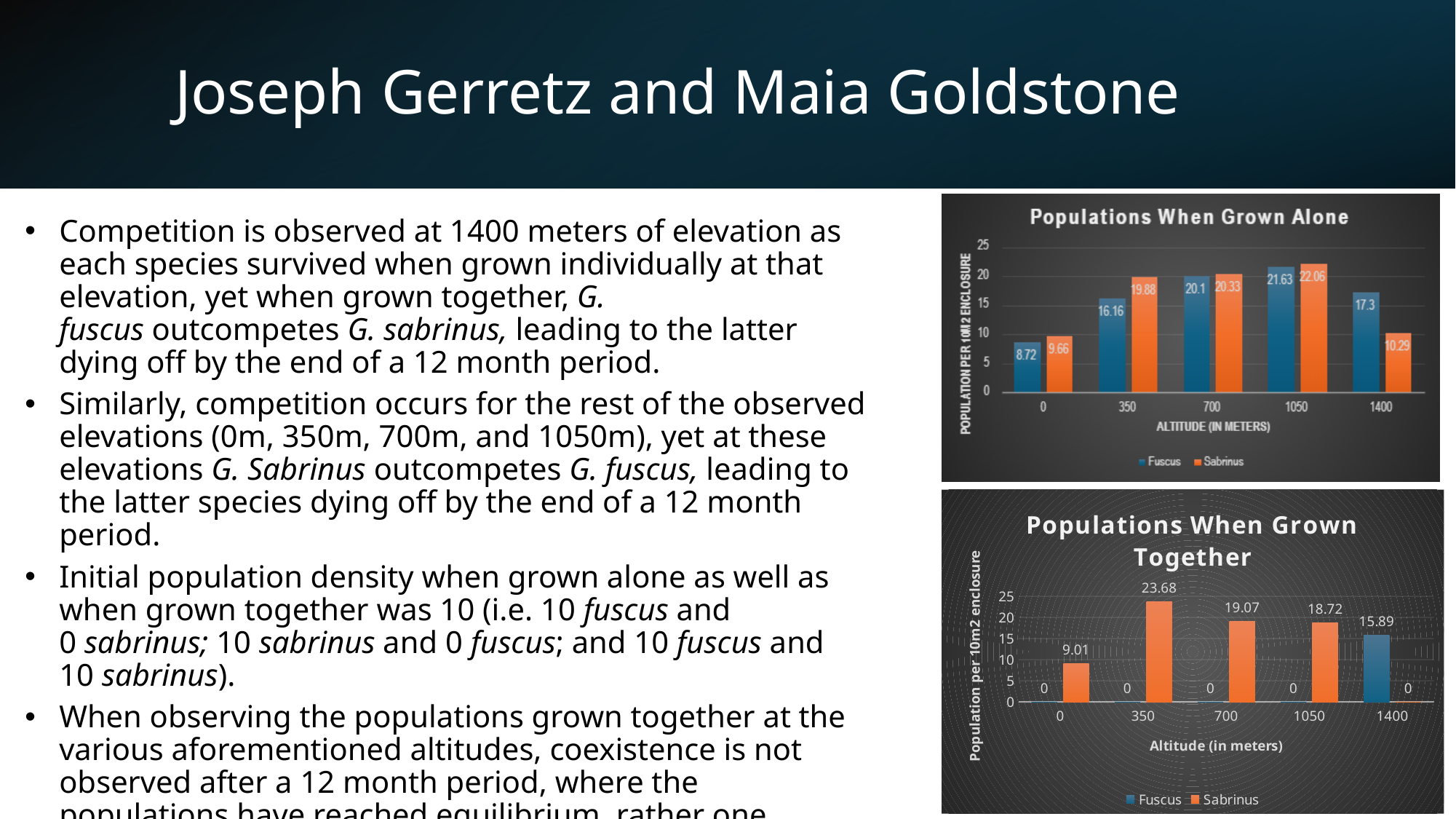
In the "Populations When Grown Alone" chart, what is the Fuscus value at 1050 meters? 21.63 In the "Populations When Grown Alone" chart, at which altitude is the Sabrinus population highest? 1050 In the "Populations When Grown Alone" chart, which series has the larger value at 350 meters, Fuscus or Sabrinus? Sabrinus In the "Populations When Grown Together" chart, at which altitude is the Sabrinus population highest? 350 In the "Populations When Grown Alone" chart, what is the difference between the Fuscus and Sabrinus values at 1400 meters? 7.01 How many altitude categories are shown on the x axis of the "Populations When Grown Together" chart? 5 In the "Populations When Grown Alone" chart, what is the Sabrinus value at 1400 meters? 10.29 In the "Populations When Grown Together" chart, what is the Sabrinus value at 350 meters? 23.68 In the "Populations When Grown Together" chart, what is the Fuscus value at 1400 meters? 15.89 In the "Populations When Grown Alone" chart, at which altitude is the Fuscus population lowest? 0 In the "Populations When Grown Together" chart, what is the difference between the Sabrinus values at 700 and 1050 meters? 0.35 How many series does the legend of the "Populations When Grown Alone" chart list? 2